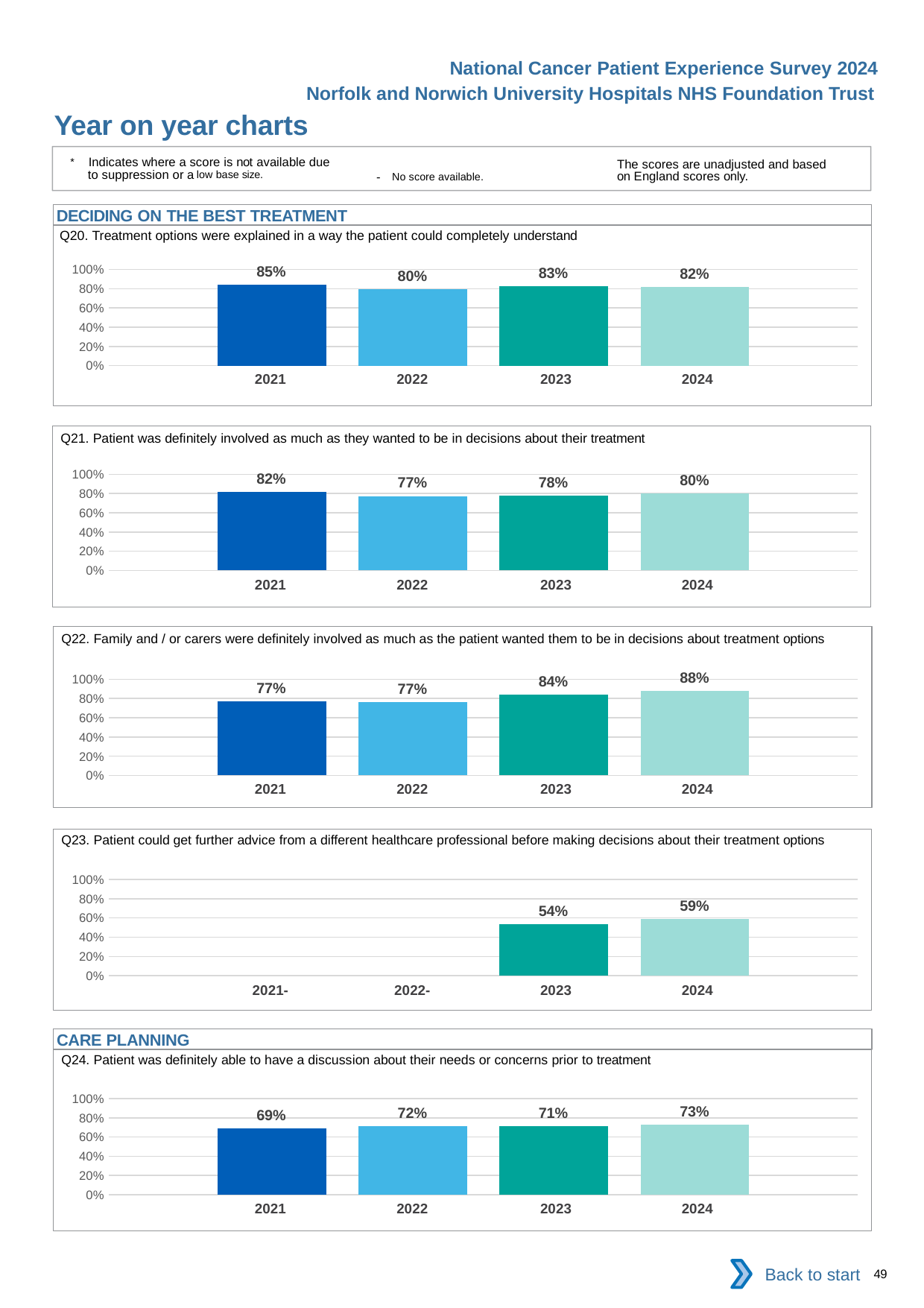
In the Q21 chart, which year has the highest value? 2021 In the Q23 chart, how many years have a bar plotted? 2 In the Q20 chart, which year has the lowest value? 2022 In the Q23 chart, is the value for 2024 greater or less than 60%? less In the Q24 chart, which is larger, the value for 2022 or the value for 2023? 2022 In the Q24 chart, what is the difference between the 2024 and 2021 values? 4% In the Q23 chart, what is the value for 2023? 54% In the Q22 chart, do the values rise or fall from 2022 to 2024? rise In the Q20 chart, what is the value for 2021? 85% In the Q22 chart, what is the value for 2024? 88% What type of chart is the Q24 chart? bar chart In the Q21 chart, what is the difference between the 2021 and 2022 values? 5%